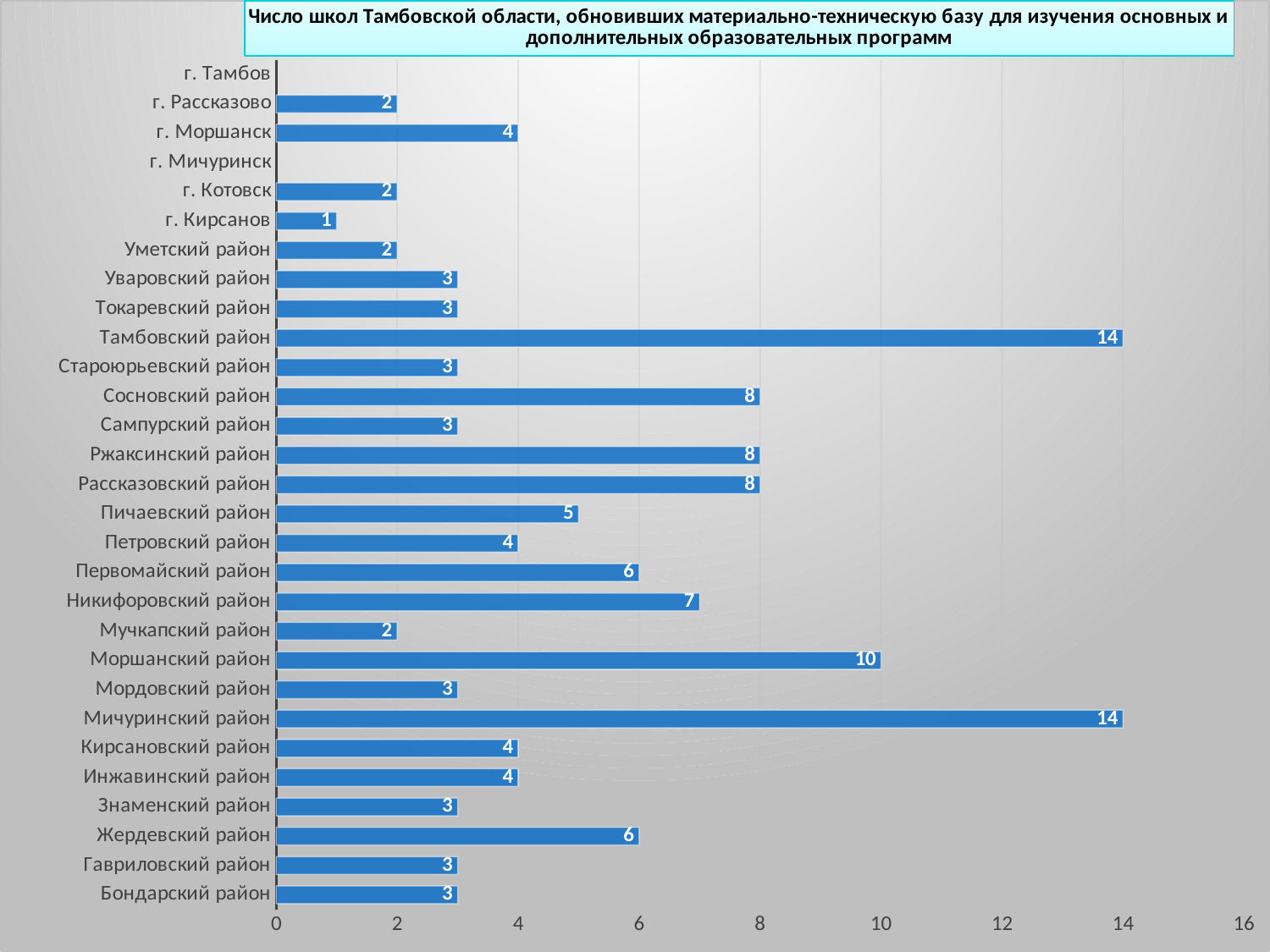
Is the value for Моршанский район greater or less than 8? greater How many categories are shown on the vertical axis of the chart? 29 What is the difference between the values for Моршанский район and Мучкапский район? 8 What kind of chart is shown on the slide? bar chart What is the value for Пичаевский район? 5 Which has a larger value, Первомайский район or Петровский район? Первомайский район What is the value for Никифоровский район? 7 What is the value for Моршанский район? 10 Which two categories share the highest value of 14? Тамбовский район and Мичуринский район What is the difference between the values for Тамбовский район and Сосновский район? 6 What is the value for Жердевский район? 6 What is the value for г. Кирсанов? 1